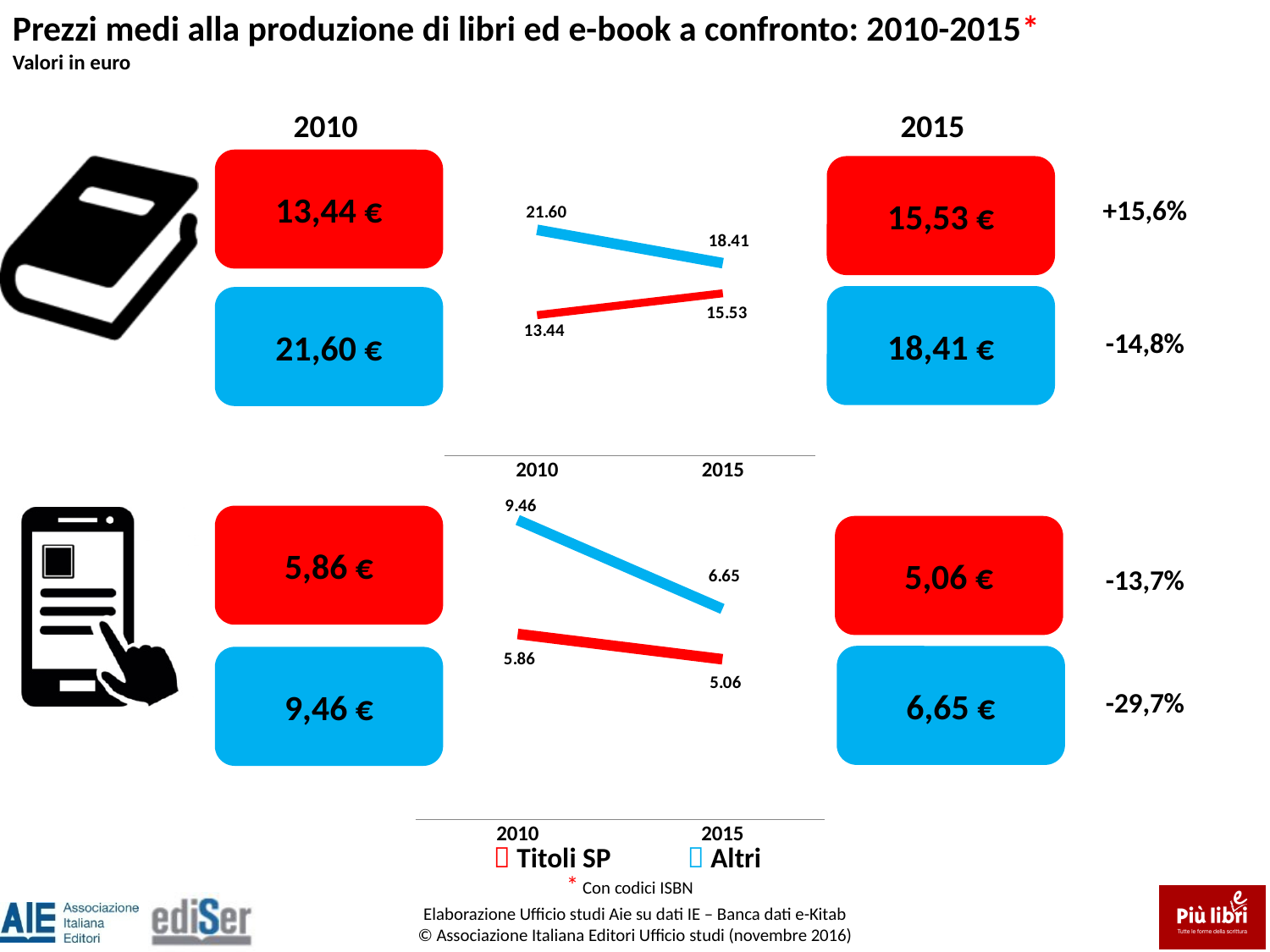
In the bottom chart (e-books), what is the difference between the Altri and Titoli SP values in 2015? 1.59 In the bottom chart (e-books), does the Altri line rise or fall from 2010 to 2015? fall In the top chart (books), what is the value for Titoli SP in 2015? 15.53 In the top chart (books), does the Titoli SP line rise or fall from 2010 to 2015? rise What colour is the Titoli SP series in the legend? red In the bottom chart (e-books), what is the value for Altri in 2015? 6.65 In the top chart (books), which series has the higher value in 2015, Titoli SP or Altri? Altri What kind of chart is the bottom chart (e-books)? line chart How many series does the legend list? 2 In the bottom chart (e-books), what is the value for Titoli SP in 2010? 5.86 In the top chart (books), what is the value for Altri in 2010? 21.60 In the top chart (books), what is the difference between the Altri values for 2010 and 2015? 3.19